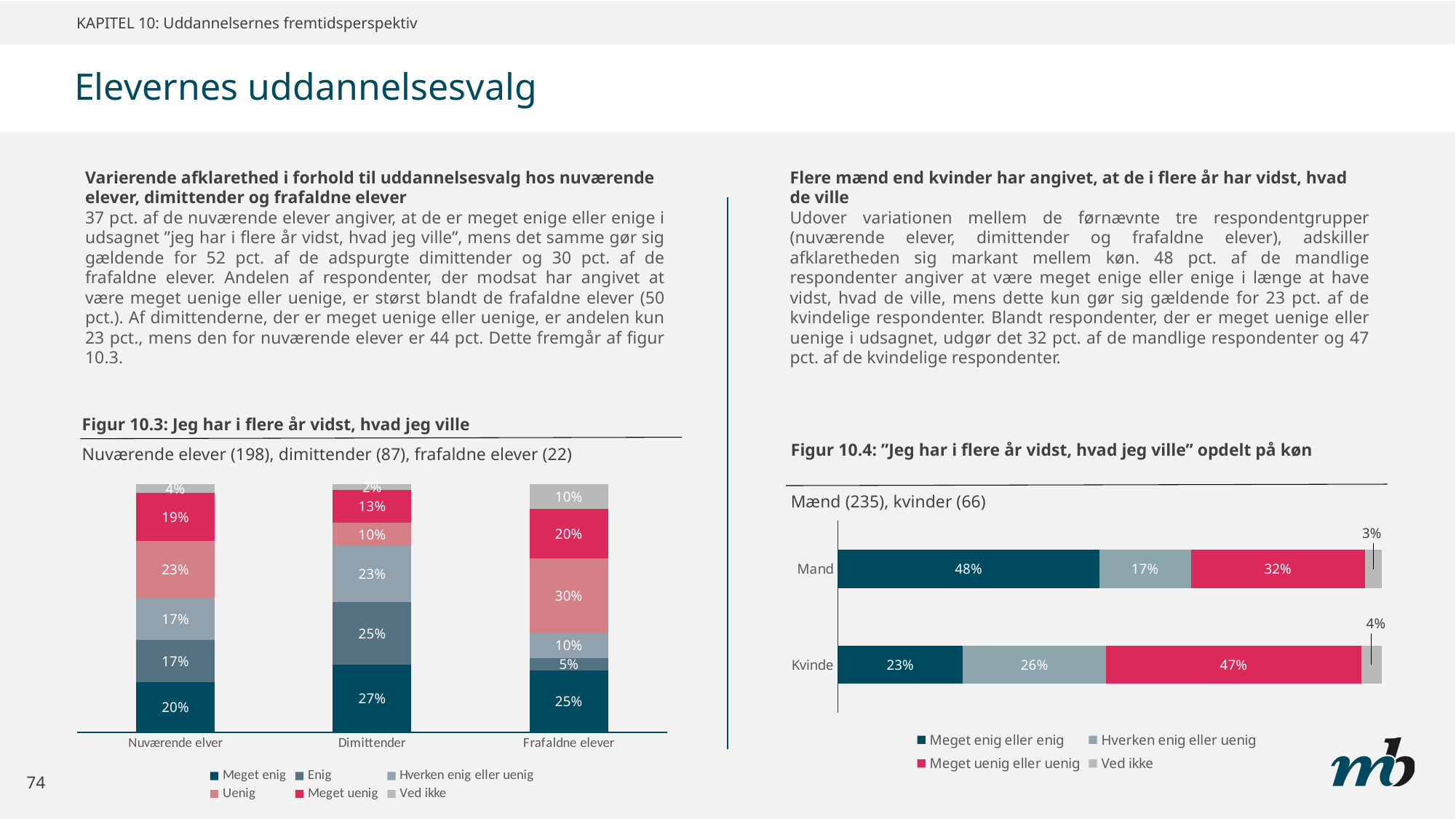
In Figur 10.3, what is the difference between the "Uenig" share for Nuværende elver and for Dimittender? 13 percentage points In Figur 10.3, which group has the lowest share of "Enig" responses? Frafaldne elever In Figur 10.3, how many series does the legend list? 6 What type of chart is Figur 10.4? Stacked bar chart In Figur 10.3, what percentage of Dimittender answered "Meget enig"? 27% In Figur 10.3, which group has the highest share of "Meget uenig" responses? Frafaldne elever In Figur 10.4, what percentage of Mand answered "Meget enig eller enig"? 48% In Figur 10.3, what percentage of Frafaldne elever answered "Uenig"? 30% In Figur 10.4, what percentage of Kvinde answered "Meget uenig eller uenig"? 47% In Figur 10.4, which group has the larger "Hverken enig eller uenig" share, Mand or Kvinde? Kvinde In Figur 10.4, what is the difference between the "Meget enig eller enig" share for Mand and for Kvinde? 25 percentage points In Figur 10.4, how many categories (groups) are shown? 2